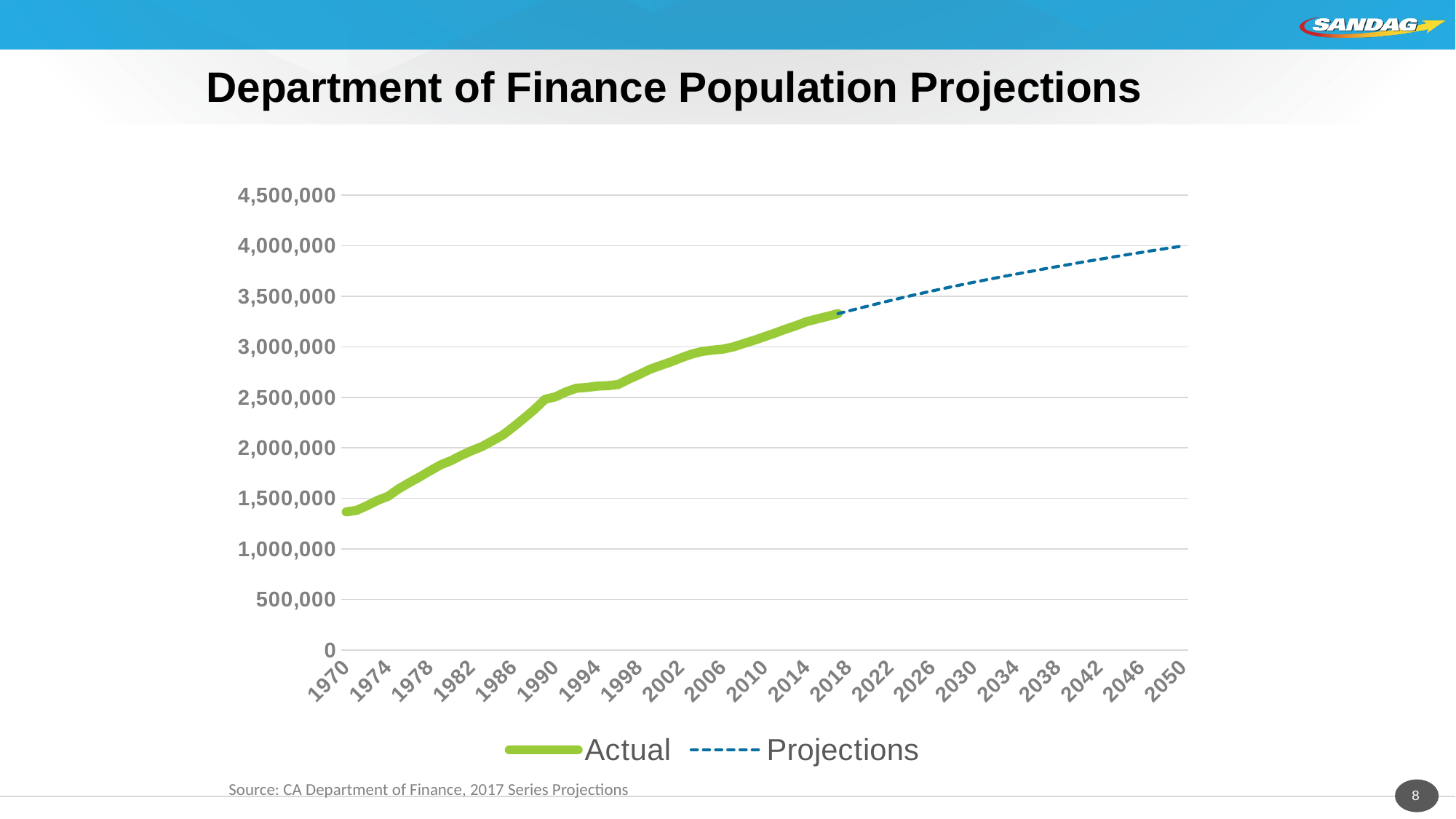
Is the Actual value for 1970 greater or less than 1,500,000? less What are the two series named in the legend? Actual and Projections What is the title of the chart? Department of Finance Population Projections Is the Projections value for 2050 greater or less than 3,500,000? greater Is the Actual value for 1978 greater or less than 1,500,000? greater What kind of chart is shown on the slide? line chart How many year labels are shown on the x axis? 21 Do the population values rise or fall from 1970 to 2050? rise How many series does the legend list? 2